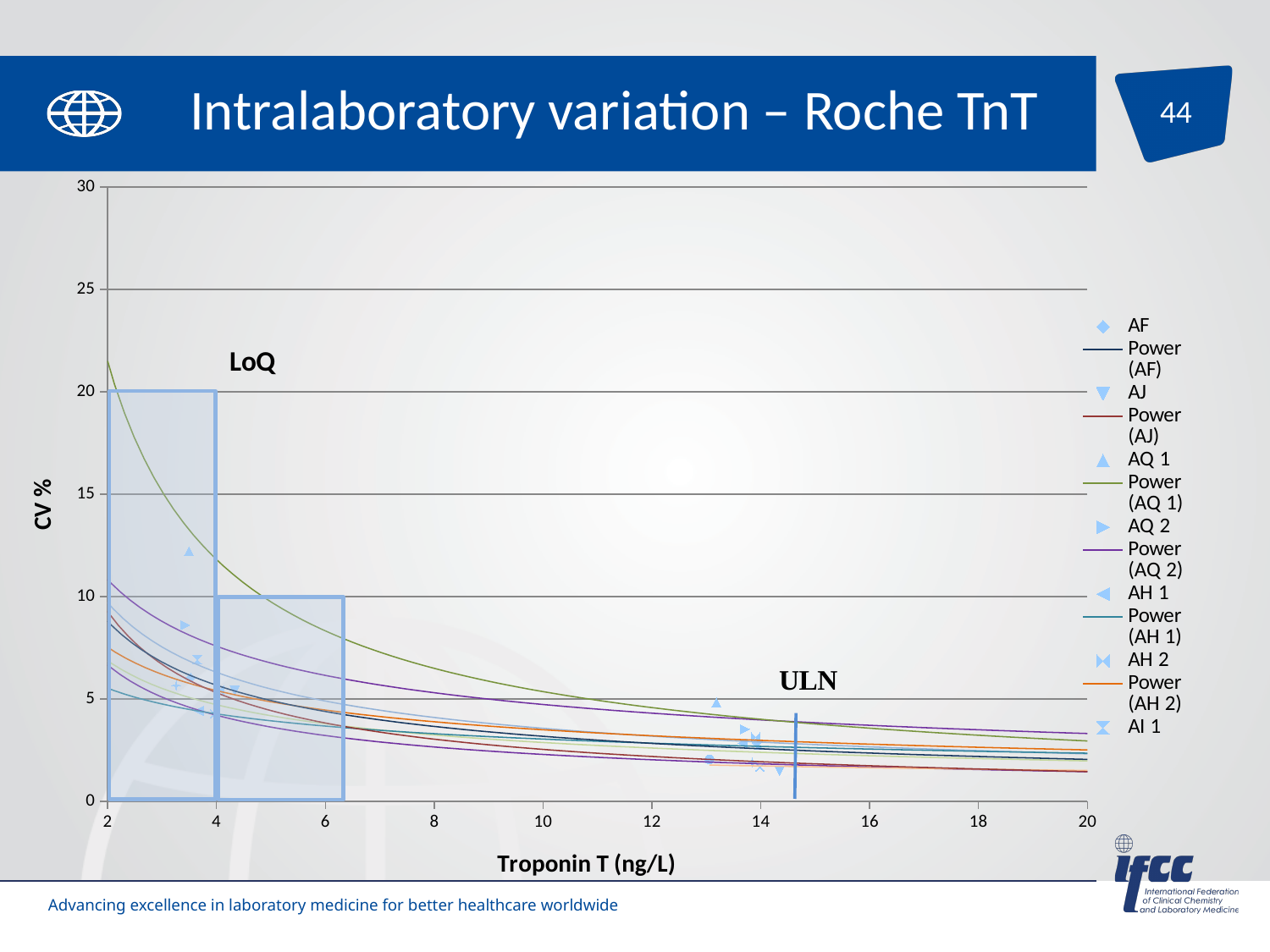
What is the label of the y axis? CV % What is the maximum value shown on the y axis? 30 What is the title of the chart on the slide? Intralaboratory variation – Roche TnT Do the trendlines rise or fall as Troponin T increases along the x axis? Fall How many entries does the legend list? 13 Is the value of the Power (AQ 1) trendline at a Troponin T of 4 ng/L greater or less than 10? greater What kind of chart is shown on the slide? Scatter chart with trendlines Is the value of the Power (AJ) trendline at a Troponin T of 20 ng/L greater or less than 5? less What label is placed next to the vertical line at about 14.6 ng/L on the chart? ULN What is the maximum value shown on the x axis? 20 Which trendline has the highest CV % at a Troponin T of 4 ng/L? Power (AQ 1) What is the label of the x axis? Troponin T (ng/L)